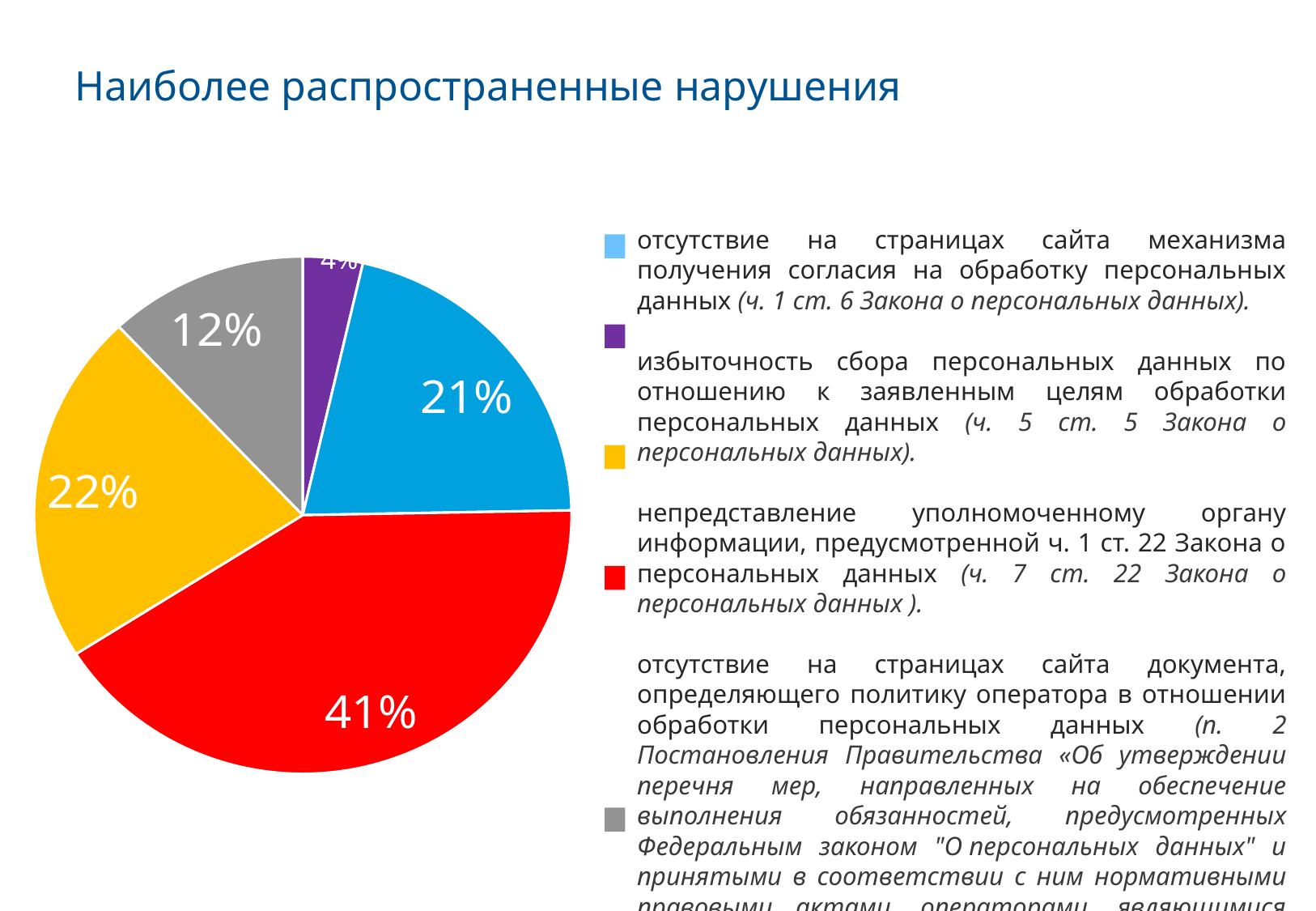
Which slice is larger, the yellow one or the blue one? yellow By how many percentage points does the red slice exceed the blue slice? 20 What percentage is shown on the purple slice of the pie chart? 4% What percentage is shown on the yellow slice of the pie chart? 22% What is the smallest share shown in the pie chart? 4% What kind of chart is shown on the slide? pie chart What is the title of the slide with the pie chart? Наиболее распространенные нарушения What percentage is shown on the red slice of the pie chart? 41% How many slices does the pie chart have? 5 What percentage is shown on the blue slice of the pie chart? 21% What is the largest share shown in the pie chart? 41% What percentage is shown on the gray slice of the pie chart? 12%